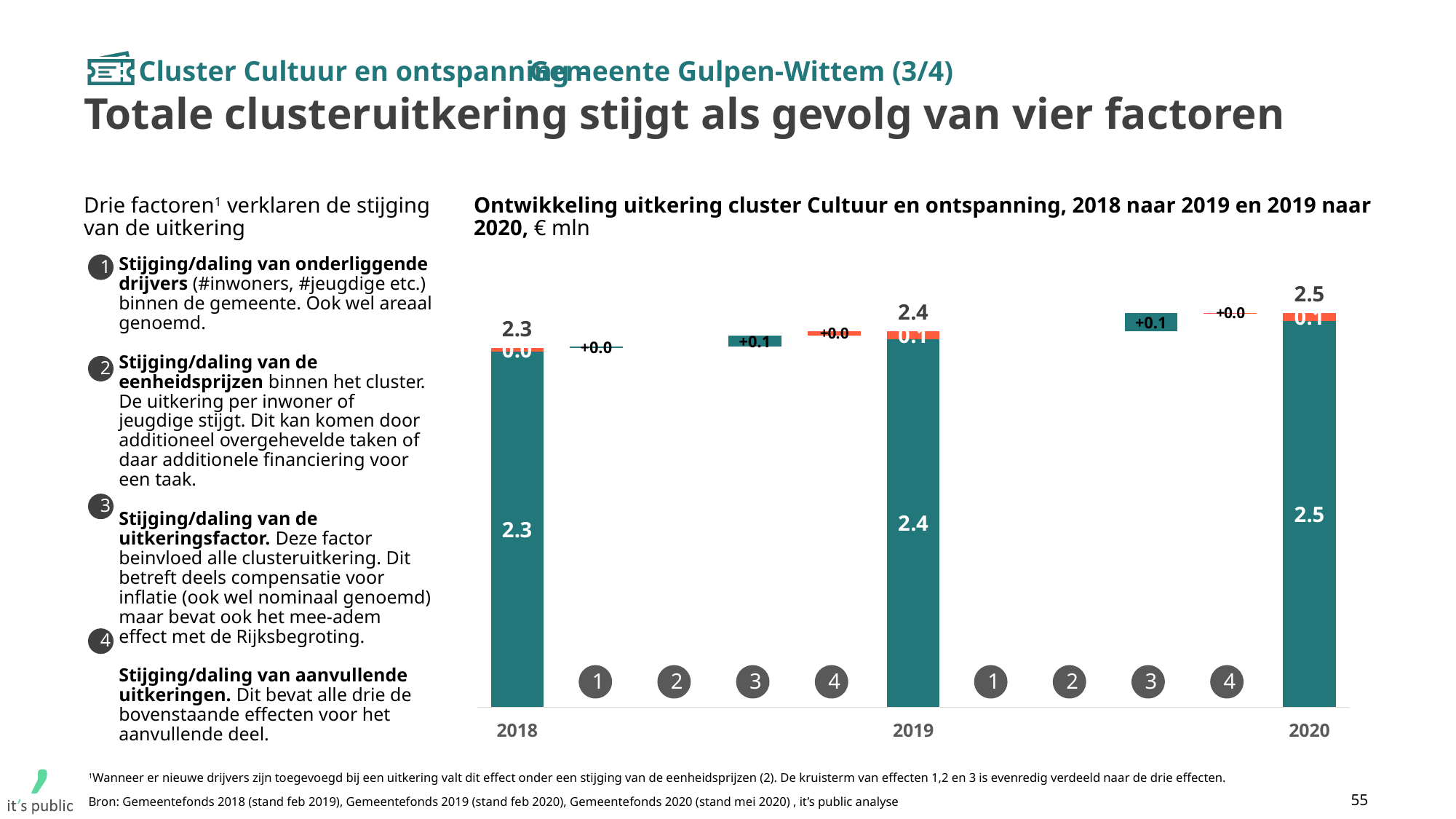
Which year has the highest total uitkering? 2020 Which is larger, the total for 2019 or the total for 2018? 2019 How many year totals are shown in the chart? 3 What is the contribution of factor 3 between 2018 and 2019? +0.1 What is the difference between the 2020 total and the 2018 total? 0.2 Do the yearly totals rise or fall from 2018 to 2020? rise What is the total uitkering shown for 2018? 2.3 In what unit are the values in the chart expressed? € mln Which year has the lowest total uitkering? 2018 What is the contribution of factor 1 between 2018 and 2019? +0.0 What is the total uitkering shown for 2019? 2.4 What is the total uitkering shown for 2020? 2.5